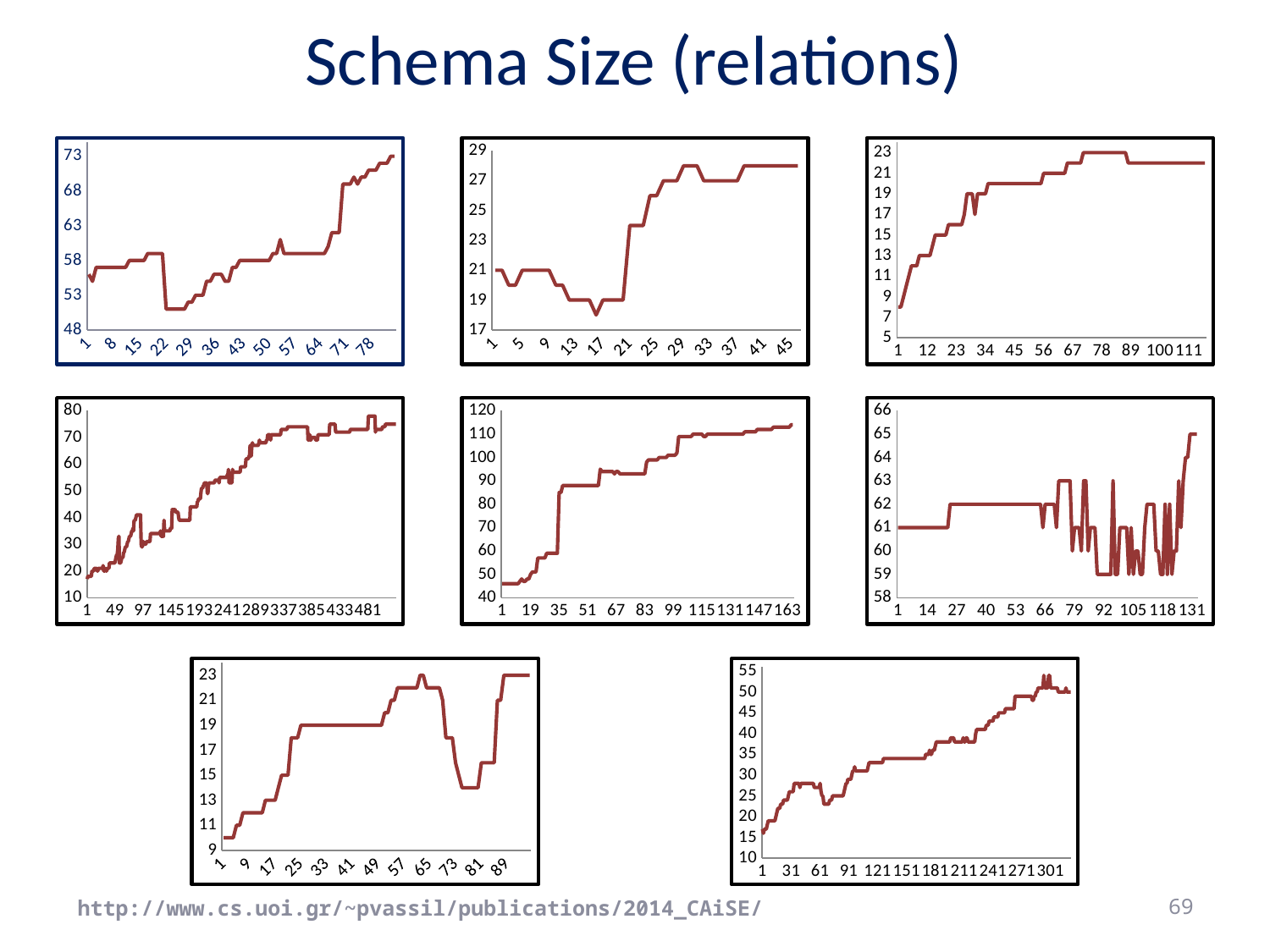
In the middle-left chart, is the value at x = 1 greater or less than 20? less In the bottom-left chart, is the value at x = 81 greater or less than 17? less What is the title of the slide? Schema Size (relations) How many charts are shown on the slide? 8 In the middle-right chart, is the value at x = 131 greater or less than 63? greater What kind of chart is the top-left chart on the slide? line chart What is the highest value shown on the y axis of the top-left chart? 73 In the middle chart of the middle row, do the values generally rise or fall along the x axis? rise